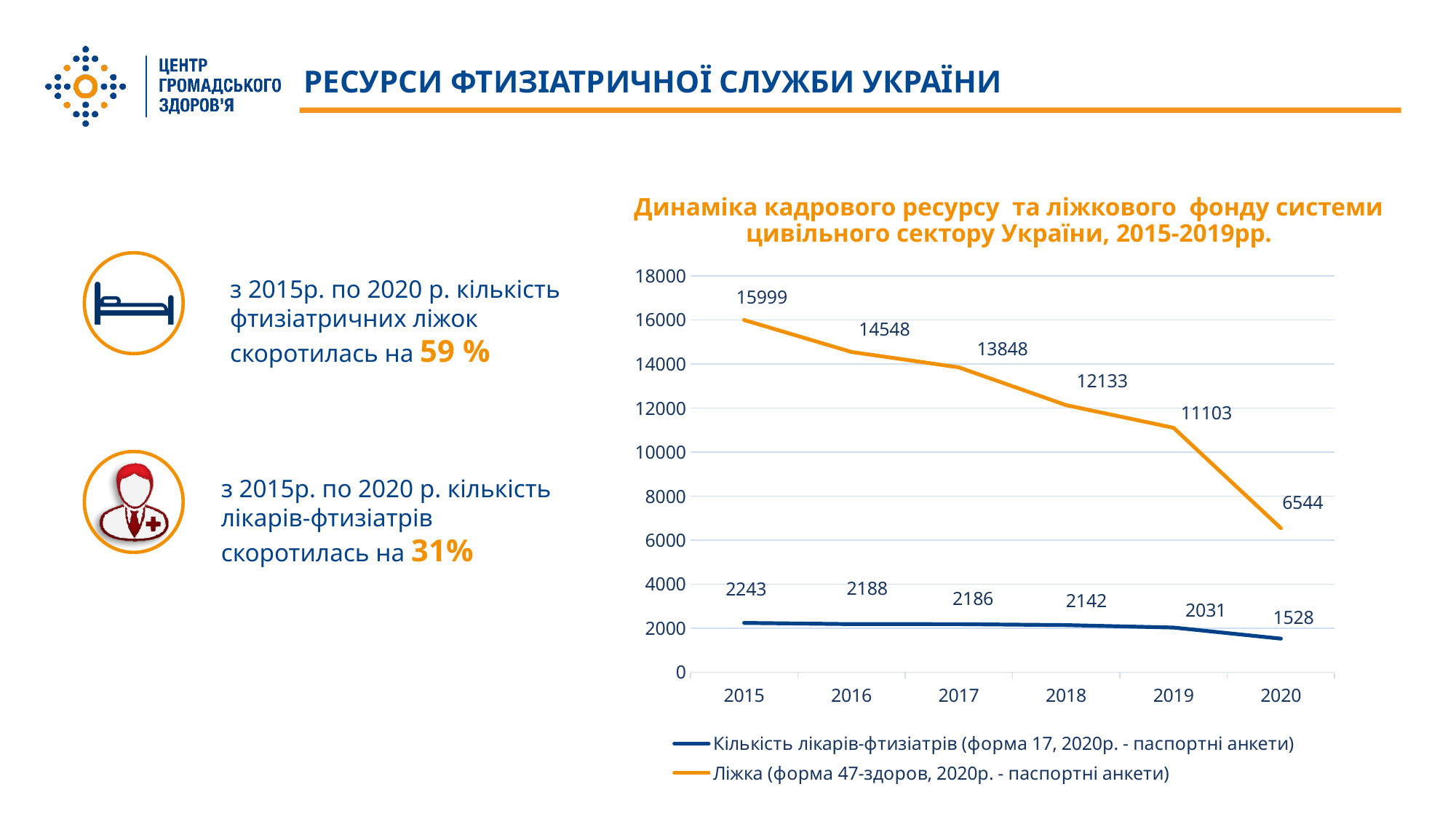
What is the value of Кількість лікарів-фтизіатрів in 2018? 2142 In which year is the Кількість лікарів-фтизіатрів series at its highest? 2015 In which year is the Ліжка series at its lowest? 2020 What is the value of Ліжка in 2015? 15999 What is the difference between the Ліжка values in 2019 and 2020? 4559 Which is larger: Ліжка in 2017 or Ліжка in 2018? Ліжка in 2017 How many series does the legend list? 2 What is the value of Ліжка in 2020? 6544 How many years are plotted on the x axis? 6 What is the difference between the Кількість лікарів-фтизіатрів values in 2015 and 2020? 715 What type of chart is shown on the slide? Line chart Do the Ліжка values rise or fall from 2015 to 2020? Fall